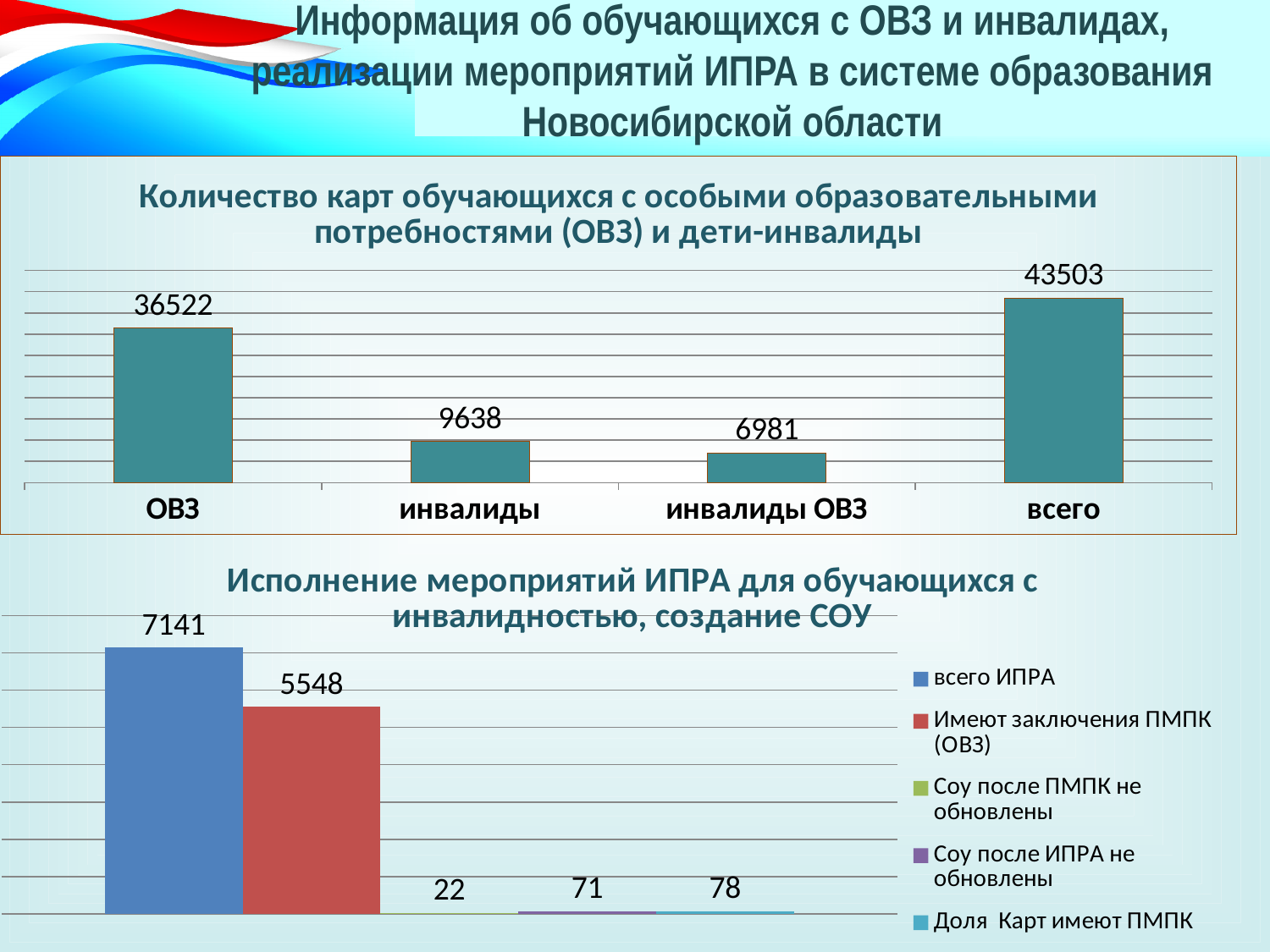
In the top chart, which is larger: инвалиды or инвалиды ОВЗ? инвалиды How many categories are shown in the top chart? 4 In the top chart, which category has the lowest value? инвалиды ОВЗ How many series does the legend of the bottom chart list? 5 In the bottom chart, what is the difference between всего ИПРА and Имеют заключения ПМПК (ОВЗ)? 1593 In the top chart, what is the difference between всего and ОВЗ? 6981 In the bottom chart, what is the value for Имеют заключения ПМПК (ОВЗ)? 5548 What type of chart is the bottom chart 'Исполнение мероприятий ИПРА для обучающихся с инвалидностью, создание СОУ'? bar chart In the bottom chart, what is the value for всего ИПРА? 7141 In the top chart 'Количество карт обучающихся с особыми образовательными потребностями (ОВЗ) и дети-инвалиды', what is the value for ОВЗ? 36522 In the top chart, which category has the highest value? всего In the top chart, what is the value for инвалиды ОВЗ? 6981